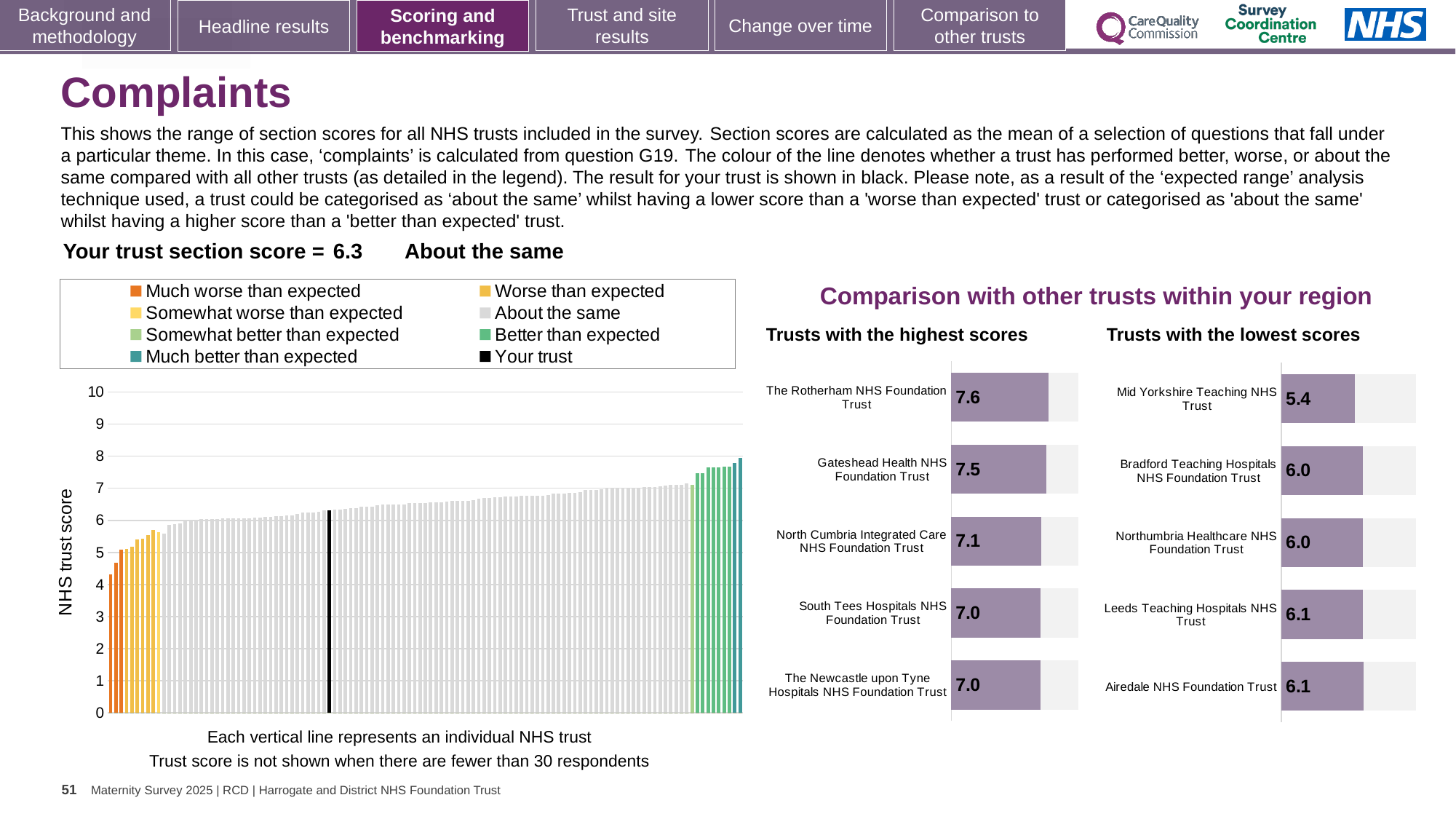
In the 'Trusts with the highest scores' chart, what is the score for North Cumbria Integrated Care NHS Foundation Trust? 7.1 In the 'Trusts with the lowest scores' chart, which trust has the lowest score? Mid Yorkshire Teaching NHS Trust In the 'Trusts with the lowest scores' chart, what is the score for Leeds Teaching Hospitals NHS Trust? 6.1 In the 'Trusts with the lowest scores' chart, what is the score for Mid Yorkshire Teaching NHS Trust? 5.4 In the large 'NHS trust score' chart on the left, what is the section score for your trust (the black bar)? 6.3 In the 'Trusts with the lowest scores' chart, what is the difference between the scores of Airedale NHS Foundation Trust and Mid Yorkshire Teaching NHS Trust? 0.7 In the large 'NHS trust score' chart on the left, do the bar values rise or fall from left to right? rise In the 'Trusts with the highest scores' chart, which trust has the highest score? The Rotherham NHS Foundation Trust Is the score for Gateshead Health NHS Foundation Trust in the 'highest scores' chart larger or smaller than the score for Bradford Teaching Hospitals NHS Foundation Trust in the 'lowest scores' chart? larger In the 'Trusts with the highest scores' chart, what is the score for The Rotherham NHS Foundation Trust? 7.6 In the 'Trusts with the highest scores' chart, what is the difference between the scores of The Rotherham NHS Foundation Trust and The Newcastle upon Tyne Hospitals NHS Foundation Trust? 0.6 How many trusts are shown in the 'Trusts with the lowest scores' chart? 5